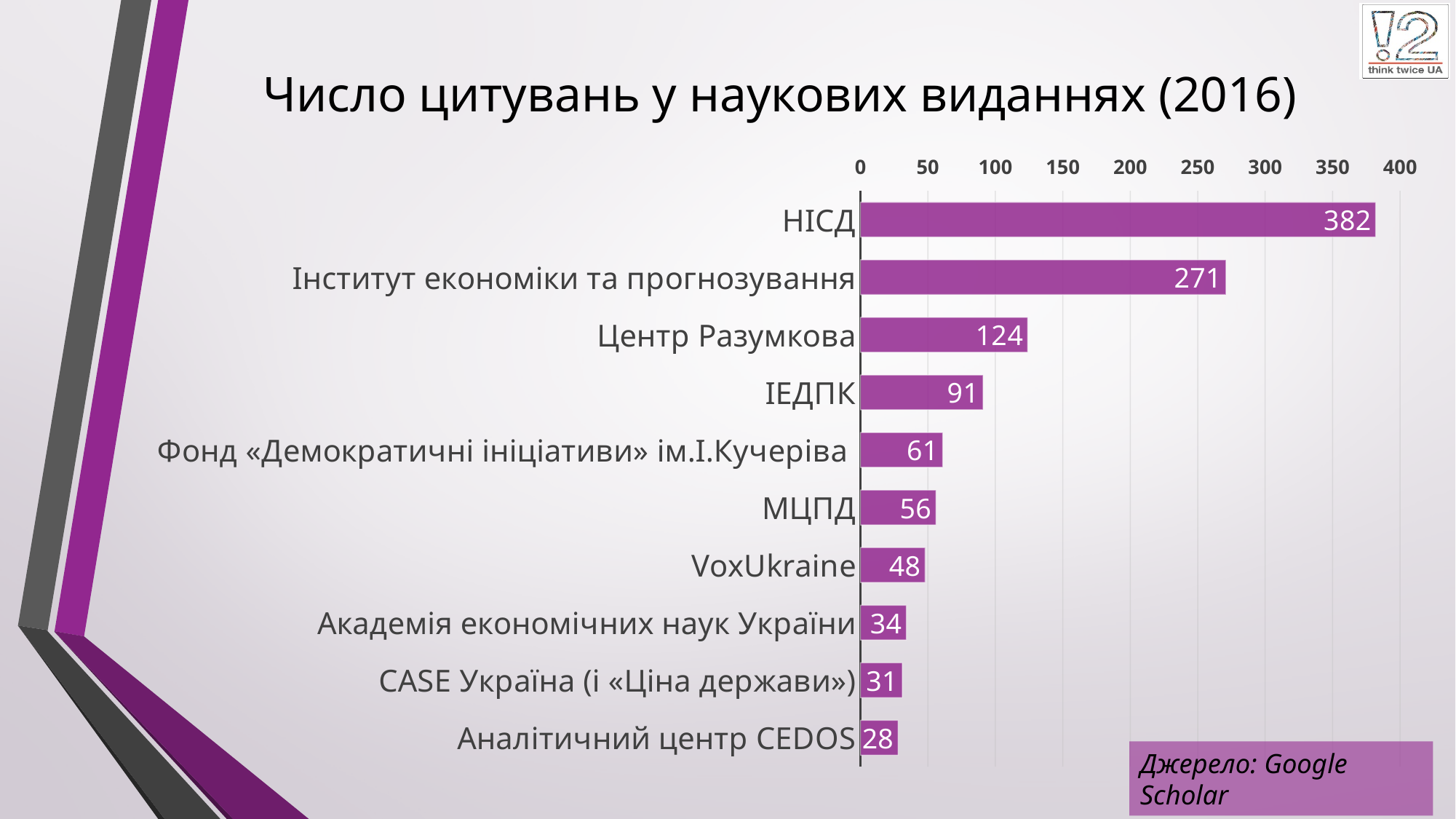
Which organisation has the lowest number of citations? Аналітичний центр CEDOS What is the title of the chart? Число цитувань у наукових виданнях (2016) What is the difference between the values for НІСД and Інститут економіки та прогнозування? 111 Which has a larger value, Центр Разумкова or ІЕДПК? Центр Разумкова Is the value for Інститут економіки та прогнозування greater or less than 250? greater What is the difference between the values for ІЕДПК and МЦПД? 35 How many organisations are shown in the chart? 10 What is the value shown for VoxUkraine? 48 What is the value shown for Центр Разумкова? 124 What is the number of citations for НІСД? 382 Which organisation has the highest number of citations? НІСД What kind of chart is shown on the slide? bar chart